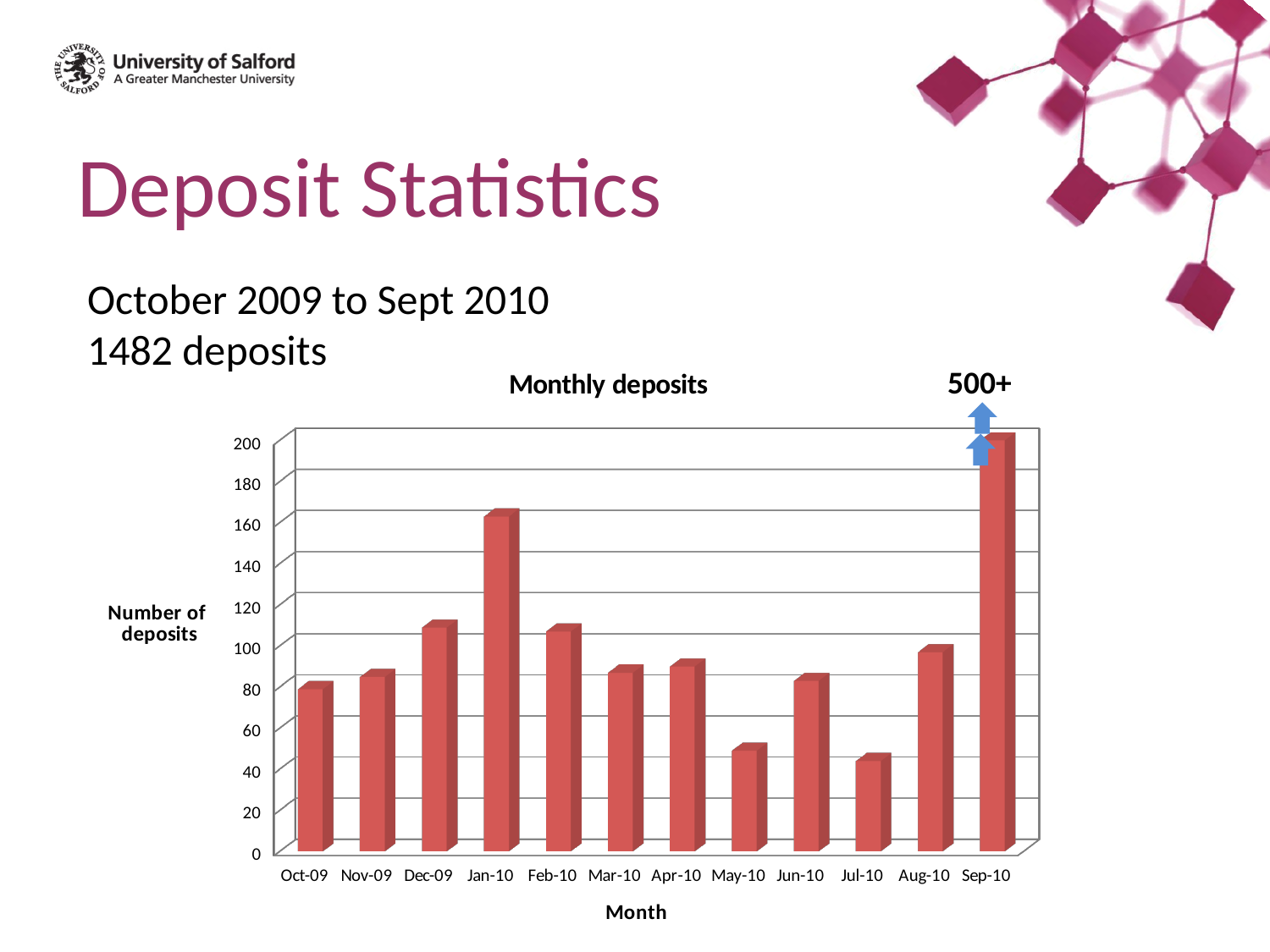
How many months are plotted in the Monthly deposits chart? 12 Is the value for Oct-09 greater or less than 100? less What is the title of the chart? Monthly deposits Which is larger, the value for Dec-09 or the value for Nov-09? Dec-09 Which is larger, the value for Jan-10 or the value for Feb-10? Jan-10 Which month has the highest bar in the Monthly deposits chart? Sep-10 Is the value for Jul-10 greater or less than 60? less Is the value for Jan-10 greater or less than 140? greater What kind of chart is shown on the slide? bar chart What label is shown on the vertical axis of the chart? Number of deposits